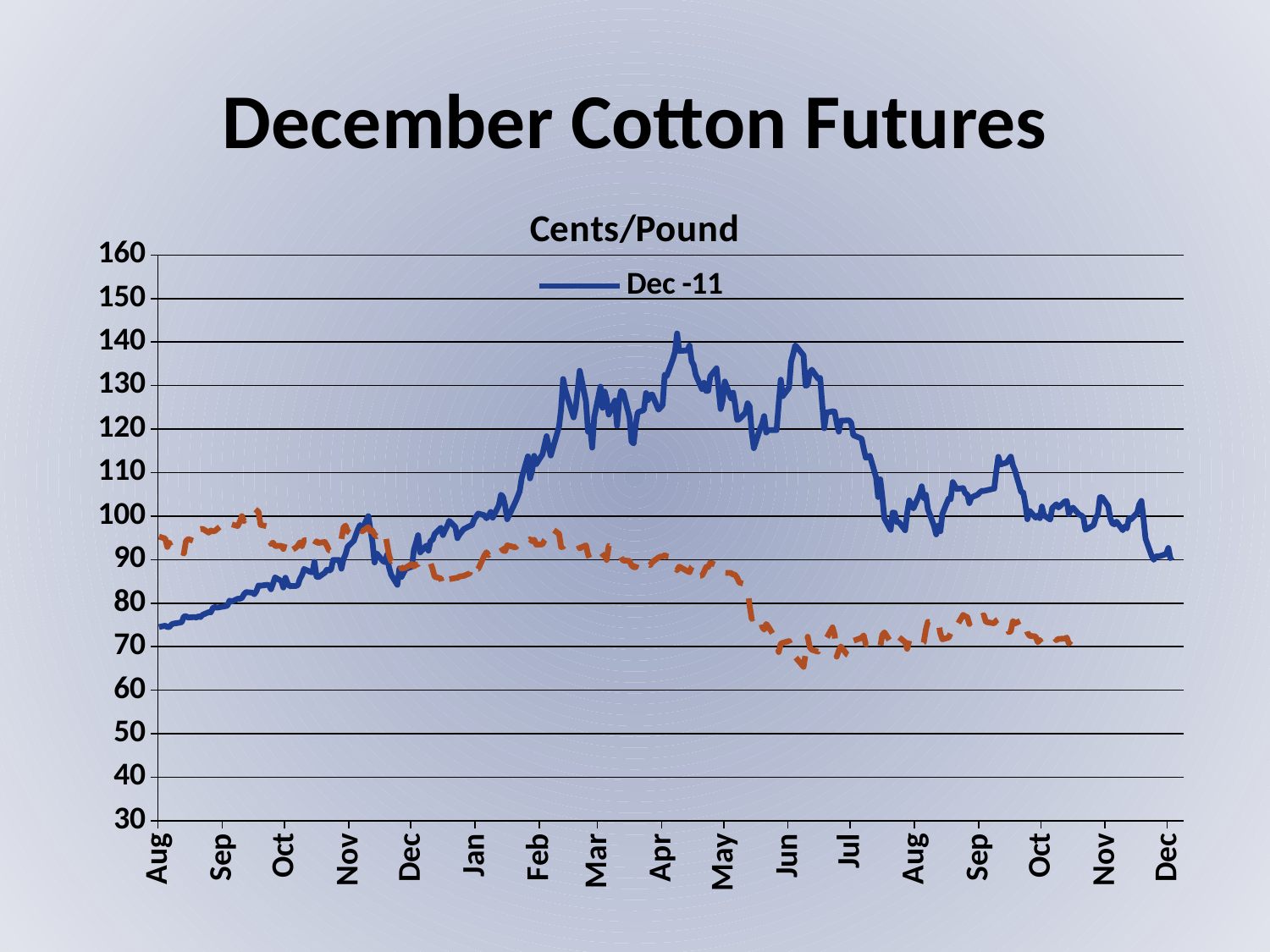
Does the Dec -11 line rise or fall from the first Aug label to the Nov label? rise Is the highest point of the Dec -11 line greater or less than 130? greater Is the Dec -11 value at the first Aug label greater or less than 80? less Does the Dec -11 line rise or fall from the Jul label to the second Aug label? fall Is the Dec -11 value at the final Dec label greater or less than 100? less Is the Dec -11 line higher at the Apr label or at the final Dec label? Apr How many series does the chart legend list? 1 How many month labels are shown along the x axis? 17 What is the title of the chart? Cents/Pound What is the name of the series listed in the legend? Dec -11 What kind of chart is shown on the slide? line chart